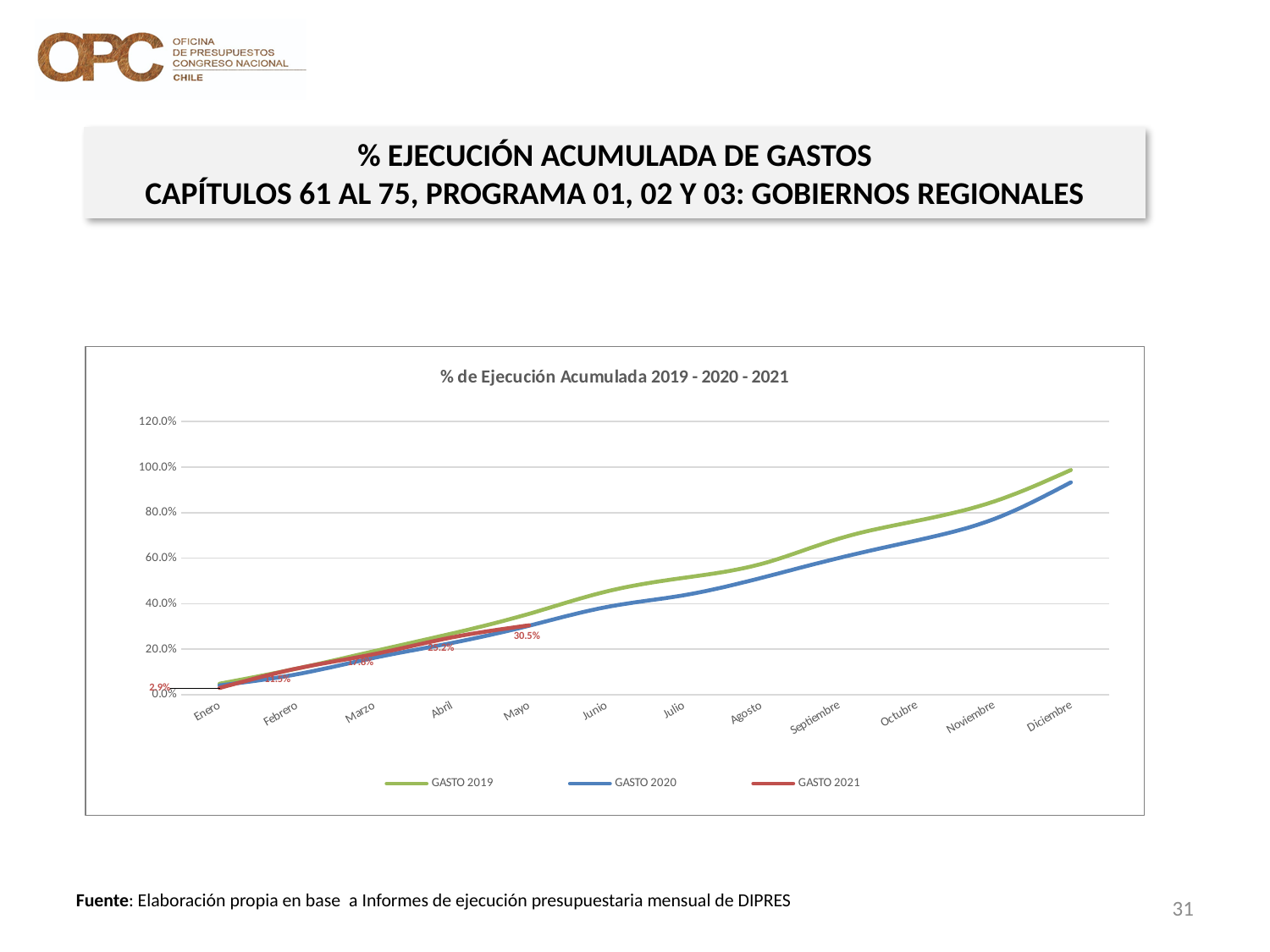
Is the value for GASTO 2020 in Agosto greater or less than 60%? less How many series does the chart legend list? 3 Is the value for GASTO 2019 in Diciembre greater or less than 80%? greater By how much did GASTO 2021 increase from Enero to Mayo? 27.6% What kind of chart is shown on the slide? line chart Do the values for GASTO 2019 rise or fall from Enero to Diciembre? rise Is the value for GASTO 2020 in Diciembre greater or less than 100%? less What is the title of the chart? % de Ejecución Acumulada 2019 - 2020 - 2021 What is the value for GASTO 2021 in Enero? 2.9% In Diciembre, which series has the higher value, GASTO 2019 or GASTO 2020? GASTO 2019 How many months are shown along the x axis of the chart? 12 What is the value for GASTO 2021 in Mayo? 30.5%